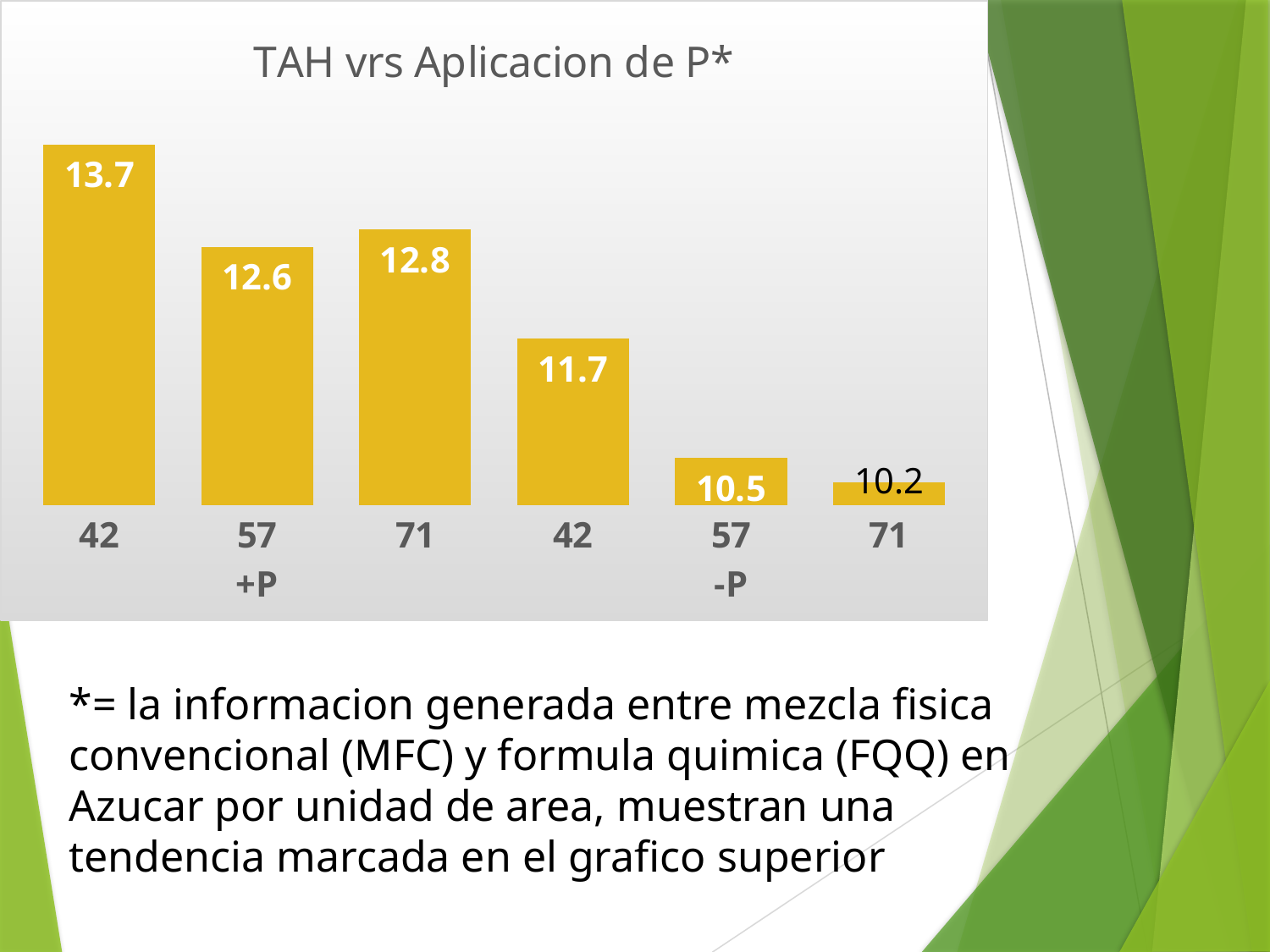
What is the difference between the value for 71 in the +P group and the value for 71 in the -P group? 2.6 Which bar has the highest value? 42 (+P) What is the title of the chart? TAH vrs Aplicacion de P* Which bar has the lowest value? 71 (-P) What kind of chart is shown on the slide? Bar chart What is the difference between the value for 42 in the +P group and the value for 42 in the -P group? 2.0 Which is larger, the value for 57 in the +P group or the value for 71 in the +P group? 71 in the +P group What is the value for 71 in the +P group? 12.8 What is the value for 42 in the -P group? 11.7 What is the value for 57 in the -P group? 10.5 What is the value for 42 in the +P group? 13.7 How many bars are shown in the chart? 6